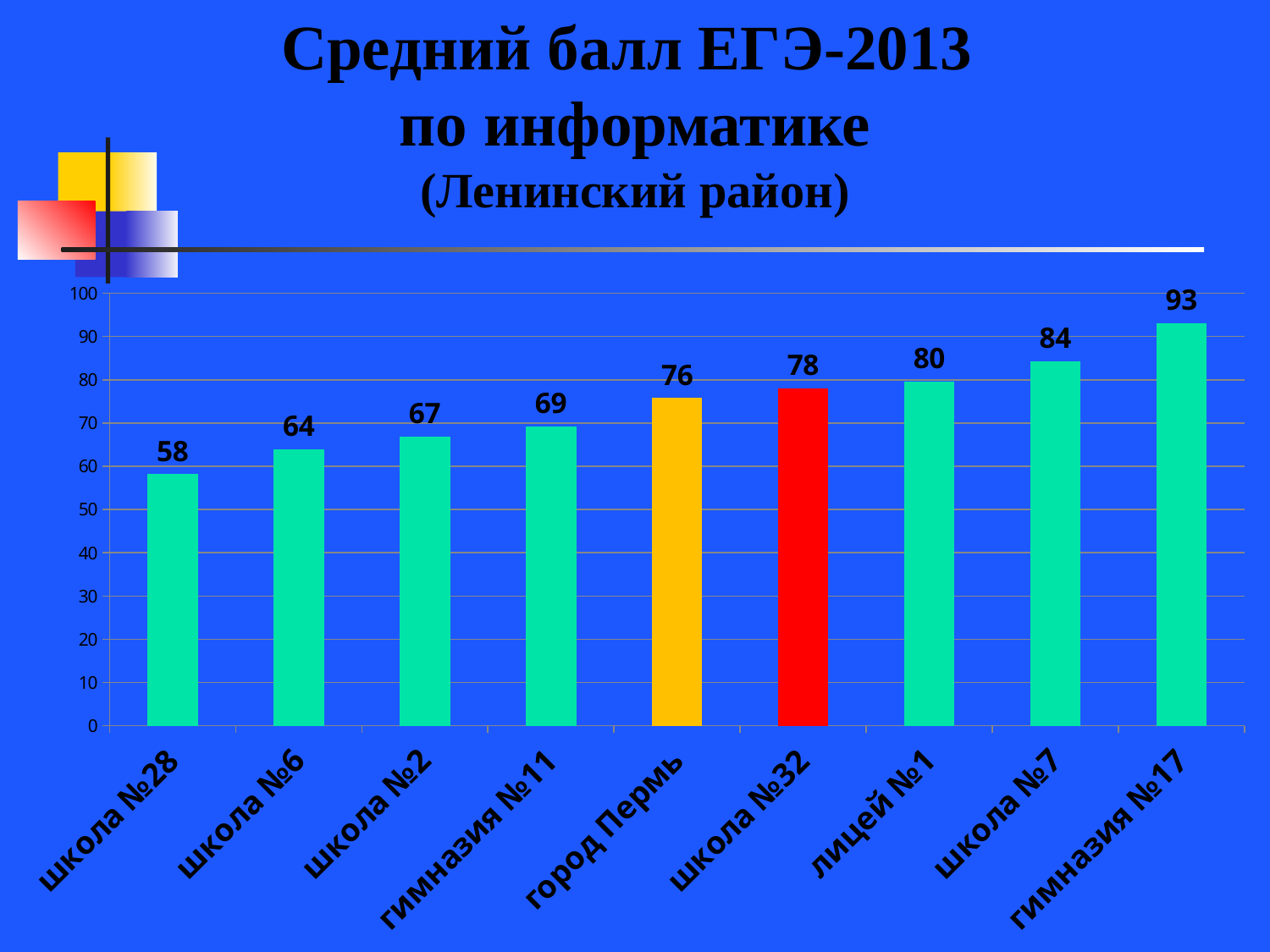
Which has a higher average score, лицей №1 or школа №7? школа №7 What is the average score for город Пермь? 76 How many categories are shown on the chart? 9 What kind of chart is shown on the slide? bar chart What is the difference between the scores of гимназия №17 and школа №28? 35 What is the difference between the scores of школа №32 and город Пермь? 2 What is the average score for школа №32? 78 Which category has the highest average score? гимназия №17 Is the value for школа №6 greater or less than 70? less What colour is the bar for школа №32? red What is the average score for гимназия №11? 69 Which category has the lowest average score? школа №28